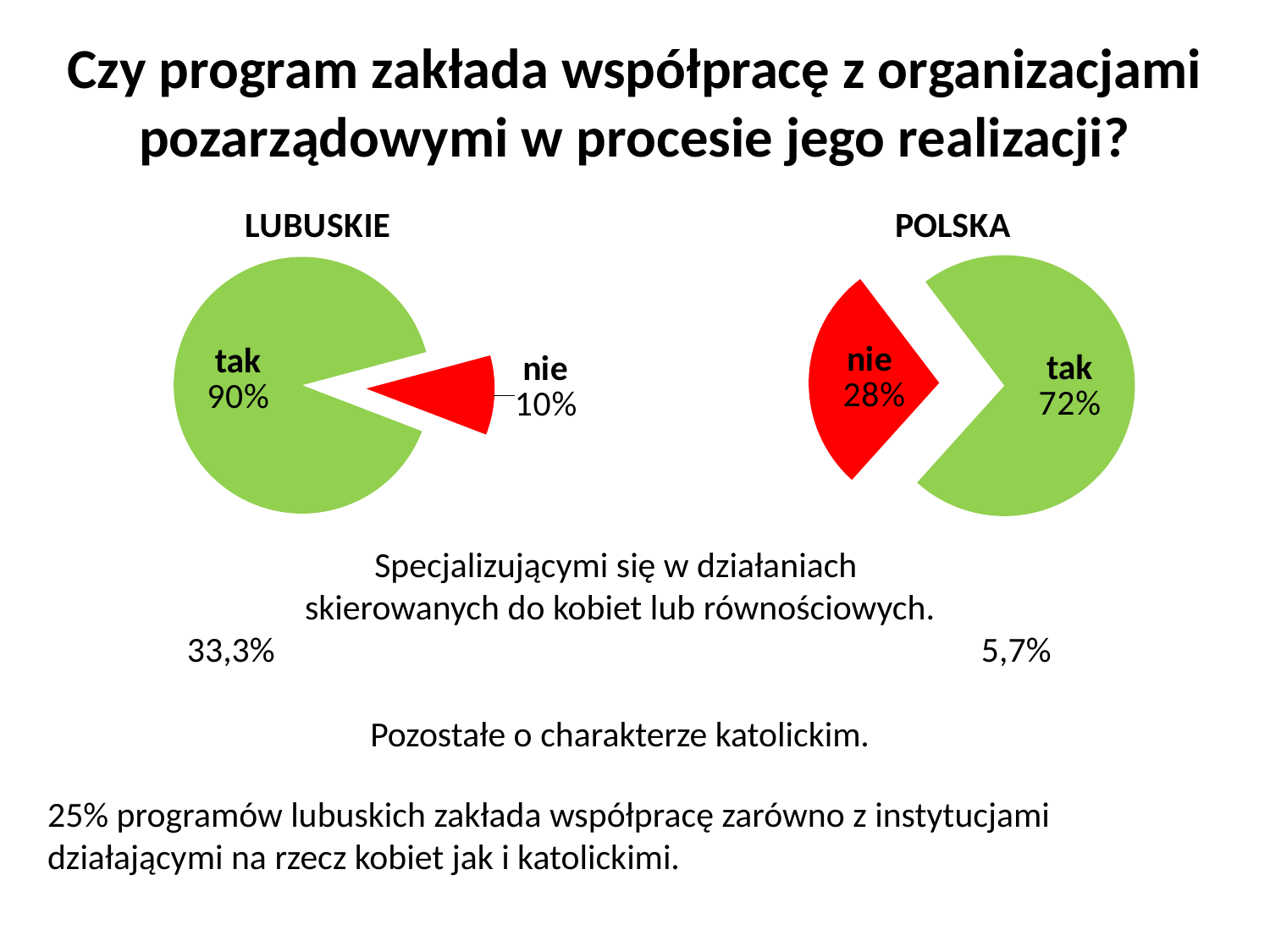
In the POLSKA chart, what is the value for "tak"? 72% In the LUBUSKIE chart, what is the value for "nie"? 10% What type of chart is the POLSKA chart? pie chart How many slices does the LUBUSKIE chart have? 2 In the LUBUSKIE chart, which slice is the largest? tak In the POLSKA chart, what is the value for "nie"? 28% In the POLSKA chart, what colour is the "nie" slice? red In the LUBUSKIE chart, what is the difference between the "tak" and "nie" values? 80% In the POLSKA chart, what is the difference between the "tak" and "nie" values? 44% In the POLSKA chart, which slice is the smallest? nie Which chart has the larger "nie" share, LUBUSKIE or POLSKA? POLSKA In the LUBUSKIE chart, what is the value for "tak"? 90%